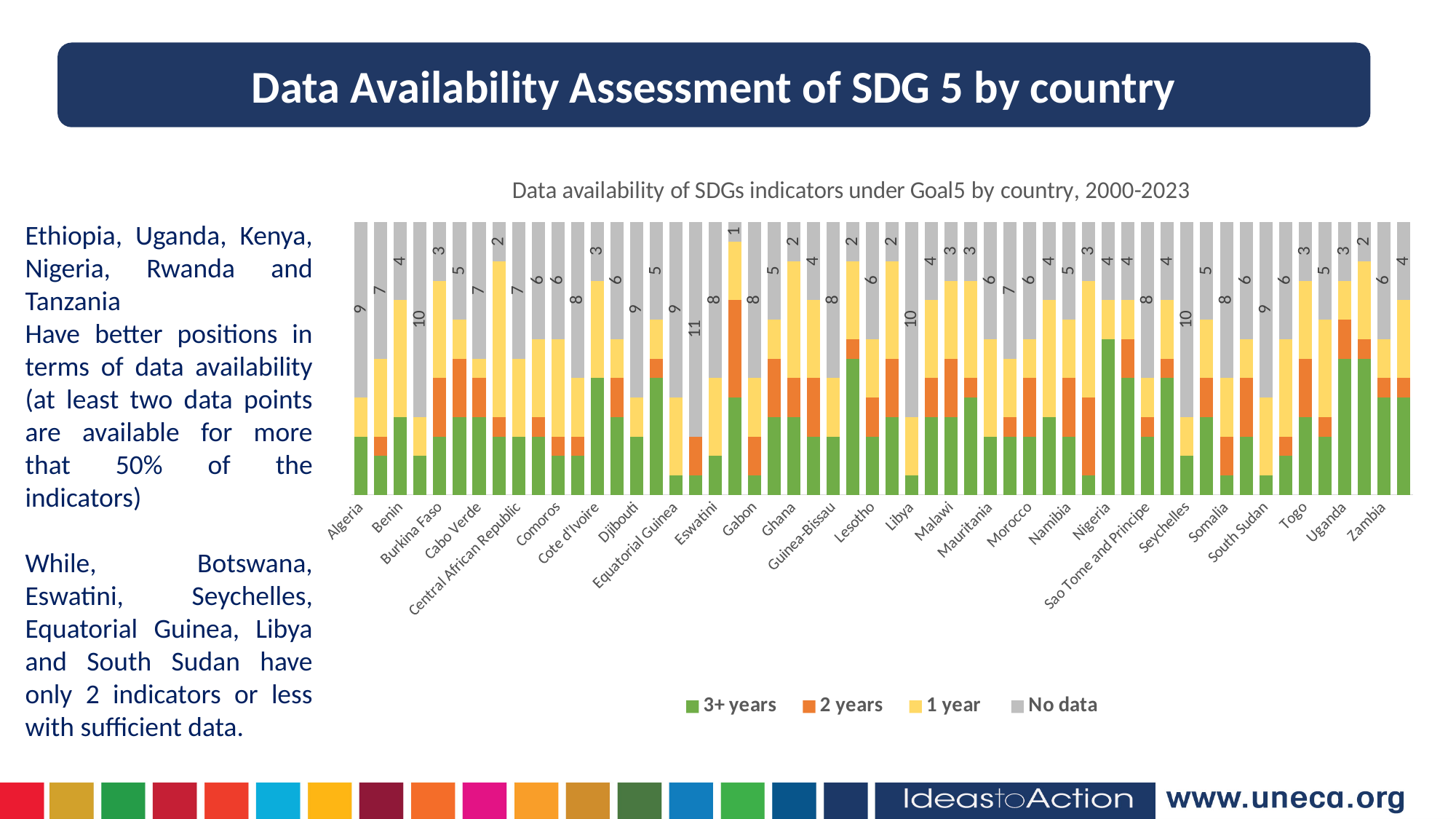
What is the 'No data' value for Cote d'Ivoire? 3 What is the title of the chart? Data availability of SDGs indicators under Goal5 by country, 2000-2023 How many series does the chart legend list? 4 What kind of chart is shown on the slide? Stacked bar chart What are the four series listed in the chart legend? 3+ years, 2 years, 1 year, No data What is the 'No data' value for Nigeria? 4 Which country has the larger 'No data' value, Libya or Togo? Libya What is the 'No data' value for Seychelles? 10 What is the highest 'No data' value labelled on any bar in the chart? 11 What is the 'No data' value for Algeria? 9 What is the 'No data' value for Libya? 10 What is the difference between the 'No data' values for Algeria and Benin? 5